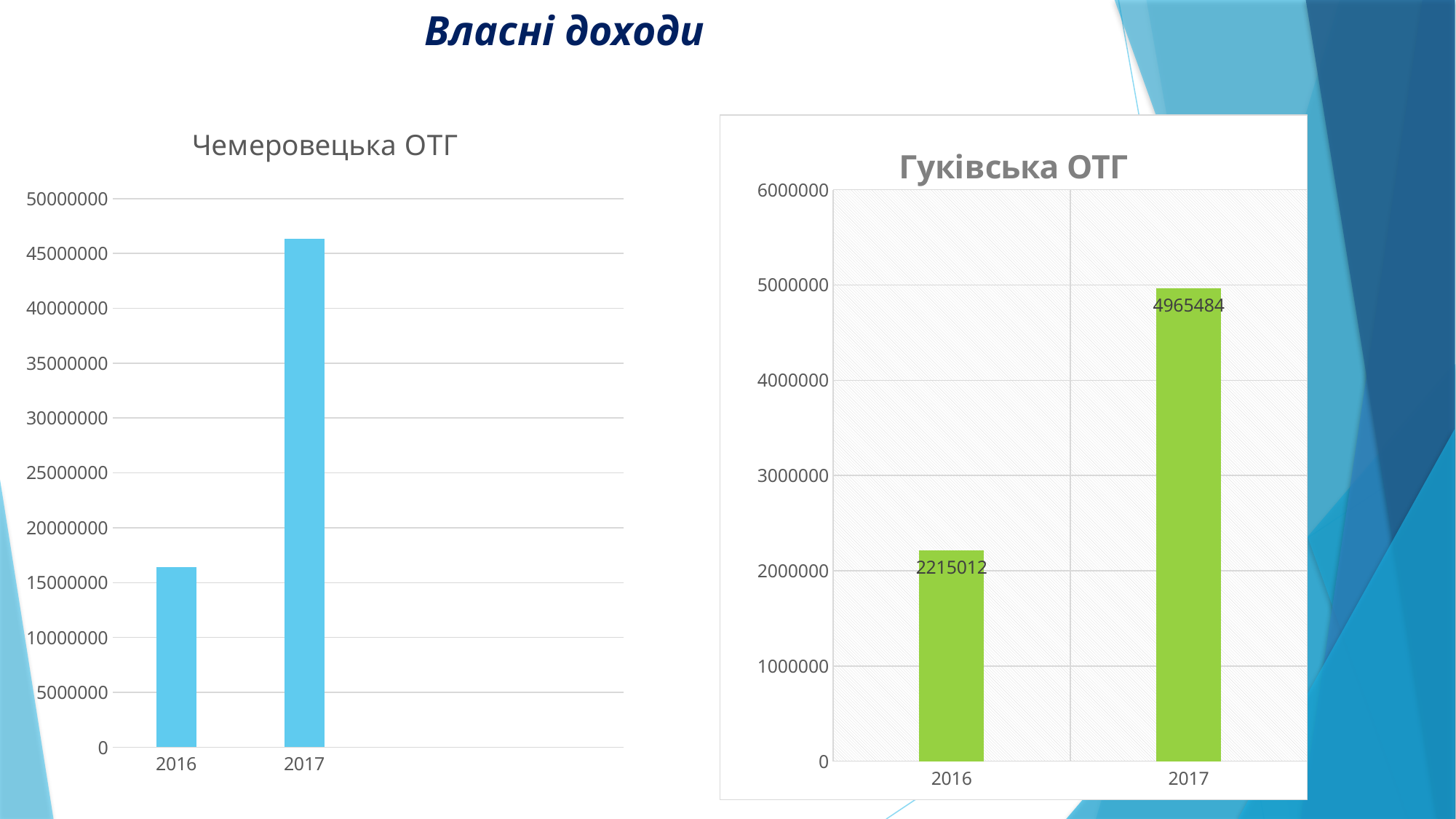
In the Гуківська ОТГ chart, which year has the higher value? 2017 What is the title of the chart on the left side of the slide? Чемеровецька ОТГ In the Гуківська ОТГ chart, what is the difference between the 2017 and 2016 values? 2750472 In the Гуківська ОТГ chart, do the values rise or fall from 2016 to 2017? rise In the Чемеровецька ОТГ chart, which is larger, the value for 2016 or the value for 2017? 2017 In the Чемеровецька ОТГ chart, is the value for 2016 greater or less than 20000000? less In the Гуківська ОТГ chart, what is the value for 2017? 4965484 In the Гуківська ОТГ chart, what is the value for 2016? 2215012 How many categories are shown on the x axis of the Гуківська ОТГ chart? 2 In the Чемеровецька ОТГ chart, is the value for 2017 greater or less than 45000000? greater What kind of chart is the Чемеровецька ОТГ chart? bar chart In the Чемеровецька ОТГ chart, which year has the lowest value? 2016